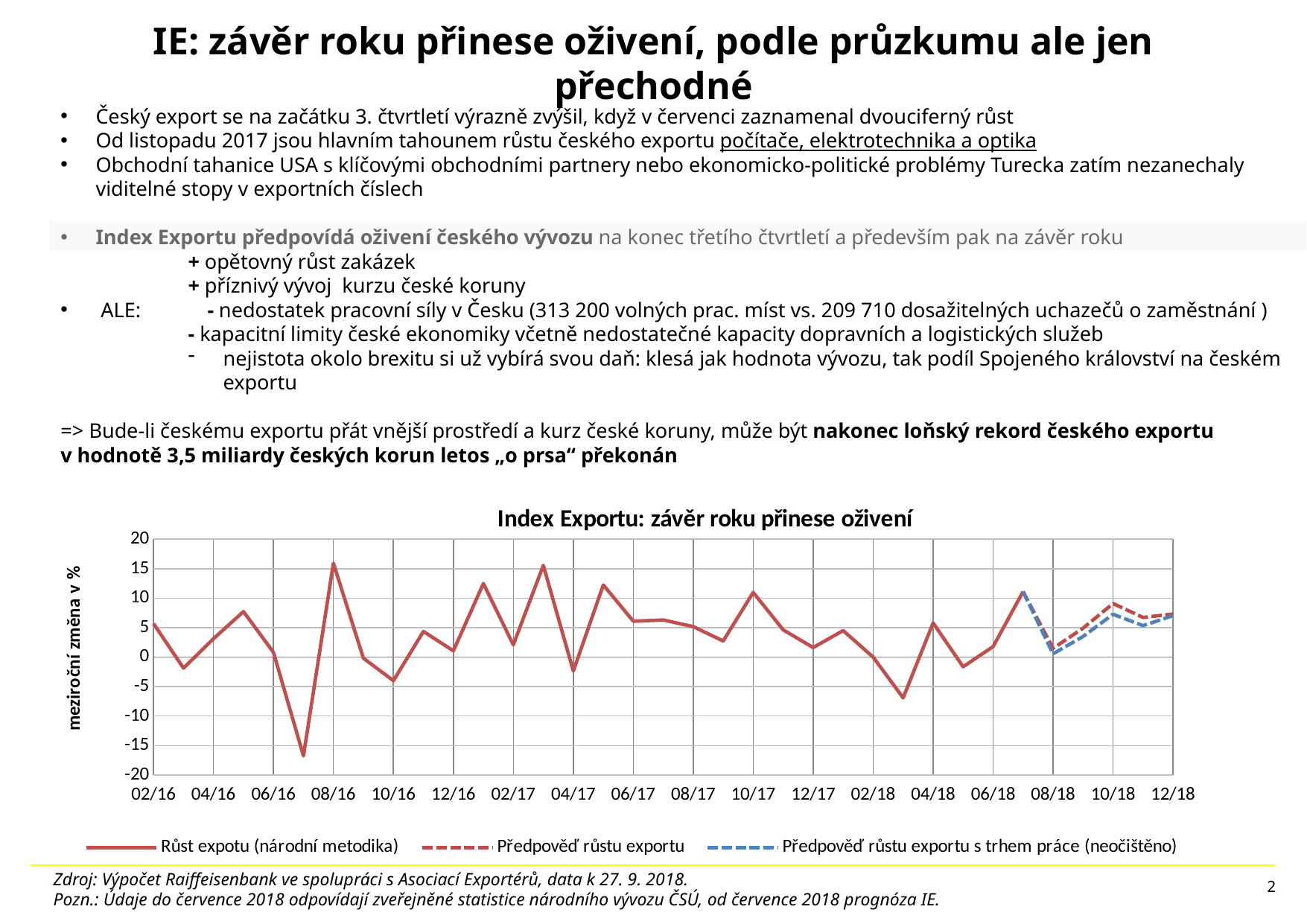
Which series is drawn as the blue dashed line? Předpověď růstu exportu s trhem práce (neočištěno) Which is larger for the solid line (Růst expotu): the value at 10/17 or the value at 12/17? 10/17 Is the value of the solid line (Růst expotu) at 10/16 greater or less than 0? less Is the value of the red dashed forecast line (Předpověď růstu exportu) at 10/18 greater or less than 5? greater Which is larger for the solid line (Růst expotu): the value at 08/16 or the value at 10/16? 08/16 How many month labels are shown on the x axis? 18 Do the forecast lines rise or fall between 08/18 and 12/18? rise How many series does the chart legend list? 3 Is the value of the solid line (Růst expotu) at 08/16 greater or less than 10? greater What kind of chart is shown on the slide? line chart What is the title of the chart? Index Exportu: závěr roku přinese oživení